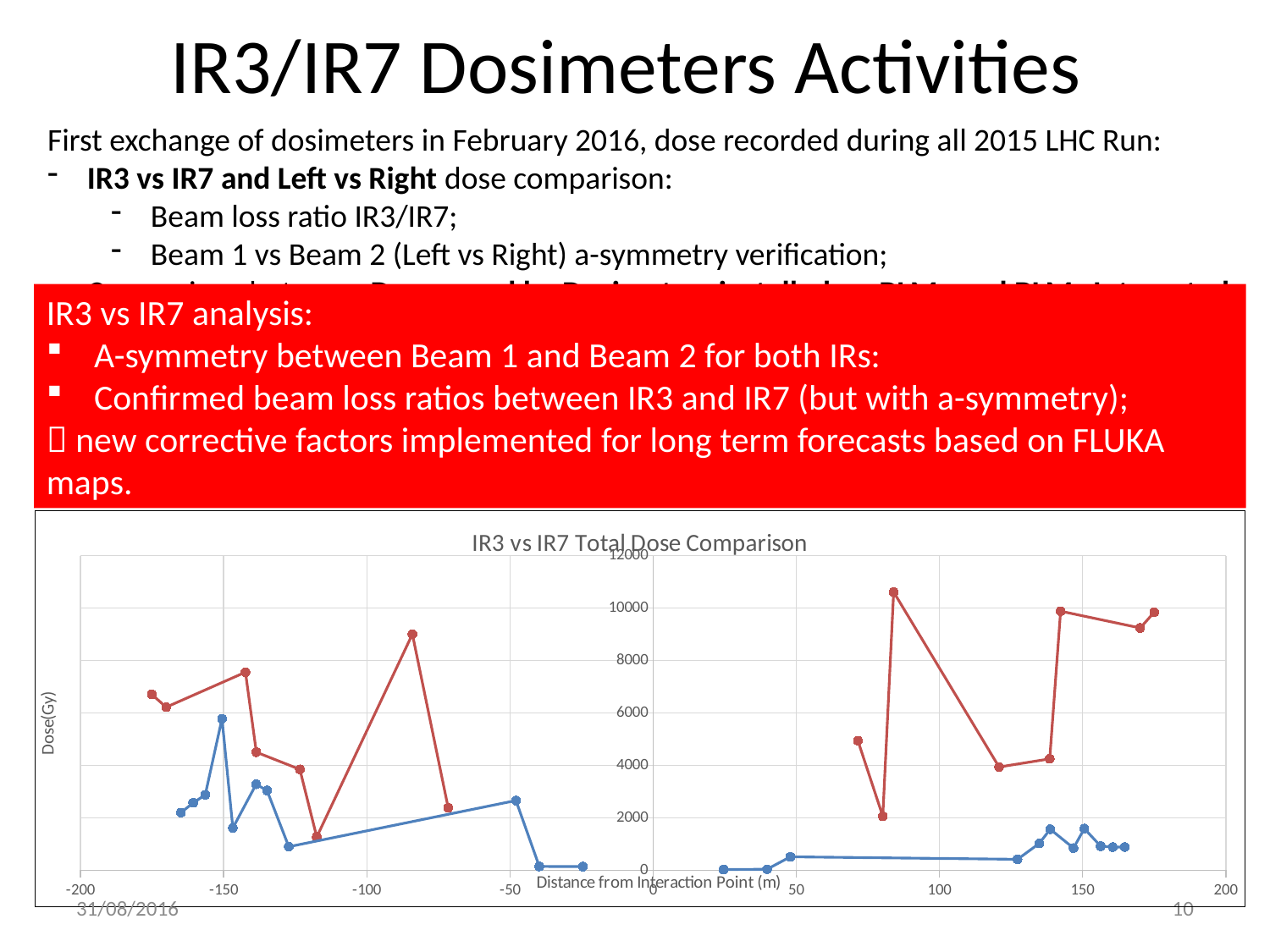
Which series reaches the highest dose value on the chart, the red one or the blue one? Red Is the highest value of the red series greater or less than 10000? greater What is the title of the chart? IR3 vs IR7 Total Dose Comparison Are the blue series values on the right-hand side of the chart (positive distances) greater or less than 2000? less What is the label of the vertical axis of the chart? Dose(Gy) What kind of chart is shown on the slide? Line chart Which series has the lowest values on the chart, the red one or the blue one? Blue Is the value of the red series at about -85 m greater or less than 8000? greater What is the maximum value shown on the vertical axis of the chart? 12000